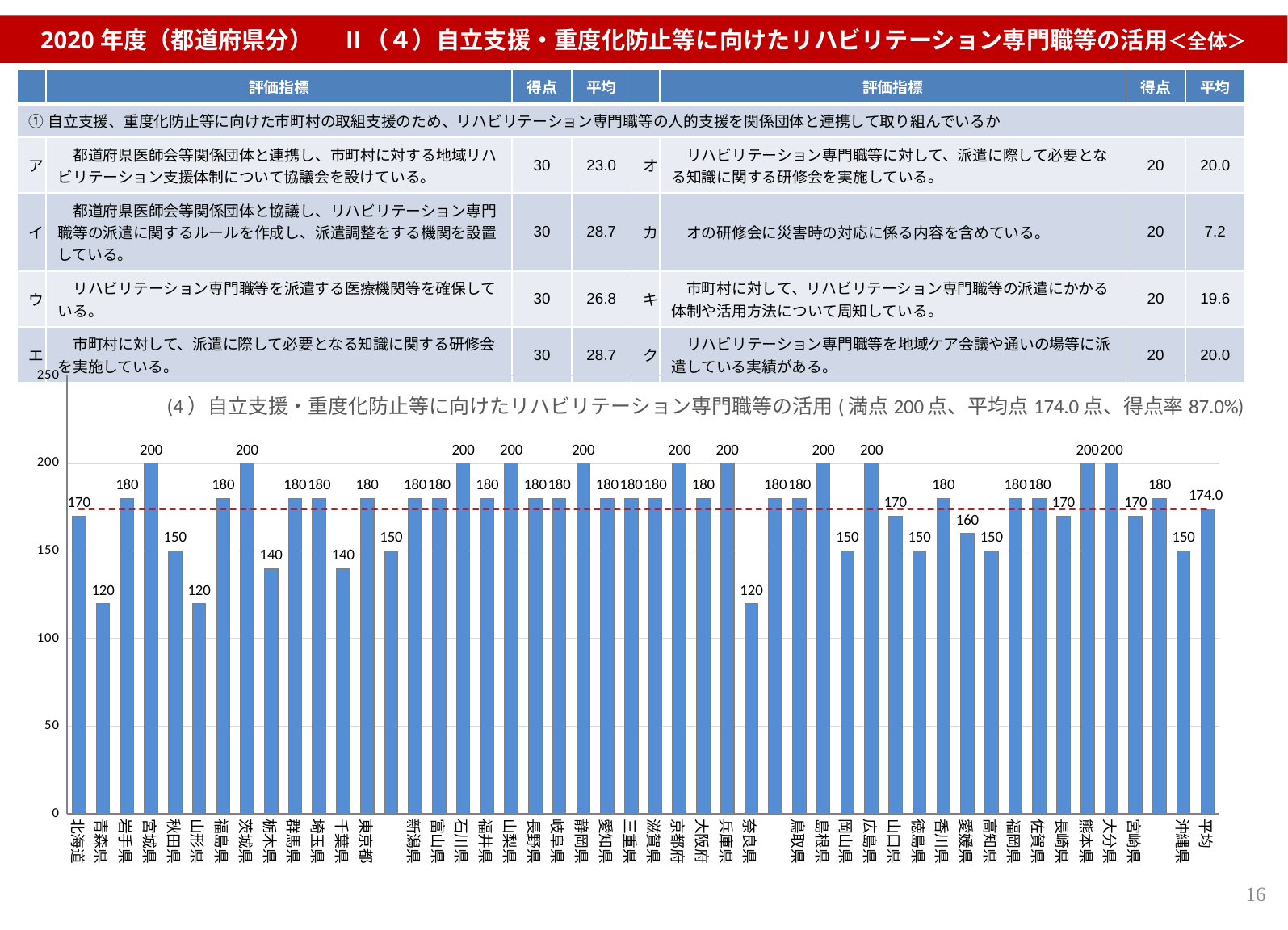
Which has the larger value, 岩手県 or 青森県? 岩手県 According to the chart title, what is the 得点率? 87.0% What is the value for 青森県? 120 What is the value for 愛媛県? 160 What is the value for 平均 (the last bar)? 174.0 What is the highest value shown on any bar in the chart? 200 What is the lowest value shown on any bar in the chart? 120 What is the value for 北海道? 170 According to the chart title, what is the 平均点? 174.0 点 Is the value for 栃木県 greater or less than 150? less What is the difference between the values for 宮城県 and 秋田県? 50 What kind of chart is shown on the slide? bar chart